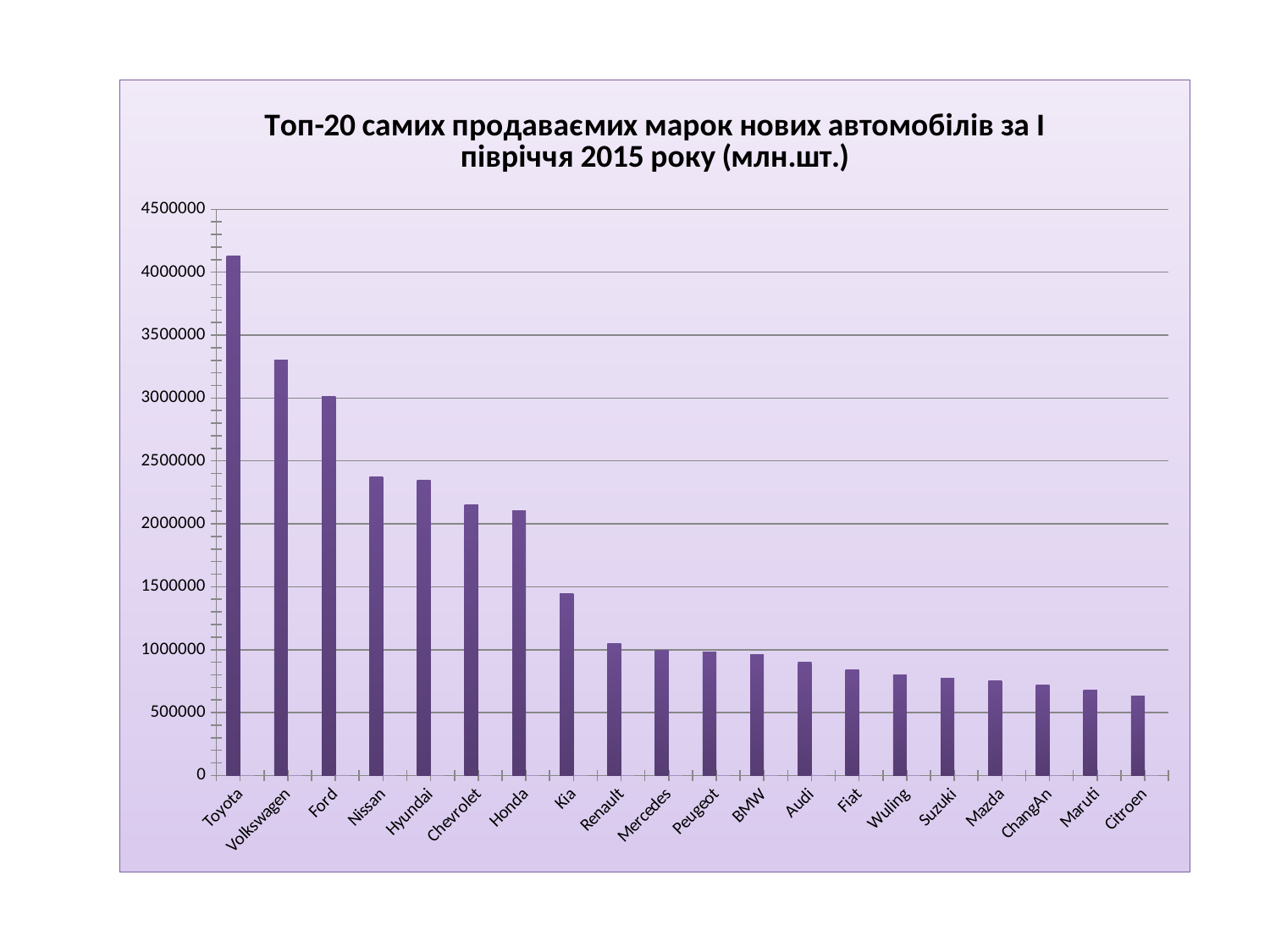
Is the value for Honda greater or less than 2000000? greater How many car brands are shown on the chart? 20 Which has a higher value, Toyota or Volkswagen? Toyota Is the value for Volkswagen greater or less than 3000000? greater Is the value for Citroen greater or less than 1000000? less Which has a higher value, Kia or Renault? Kia What kind of chart is shown on the slide? bar chart Which brand has the highest value on the chart? Toyota Do the values rise or fall from left to right along the x axis? fall Which brand has the lowest value on the chart? Citroen